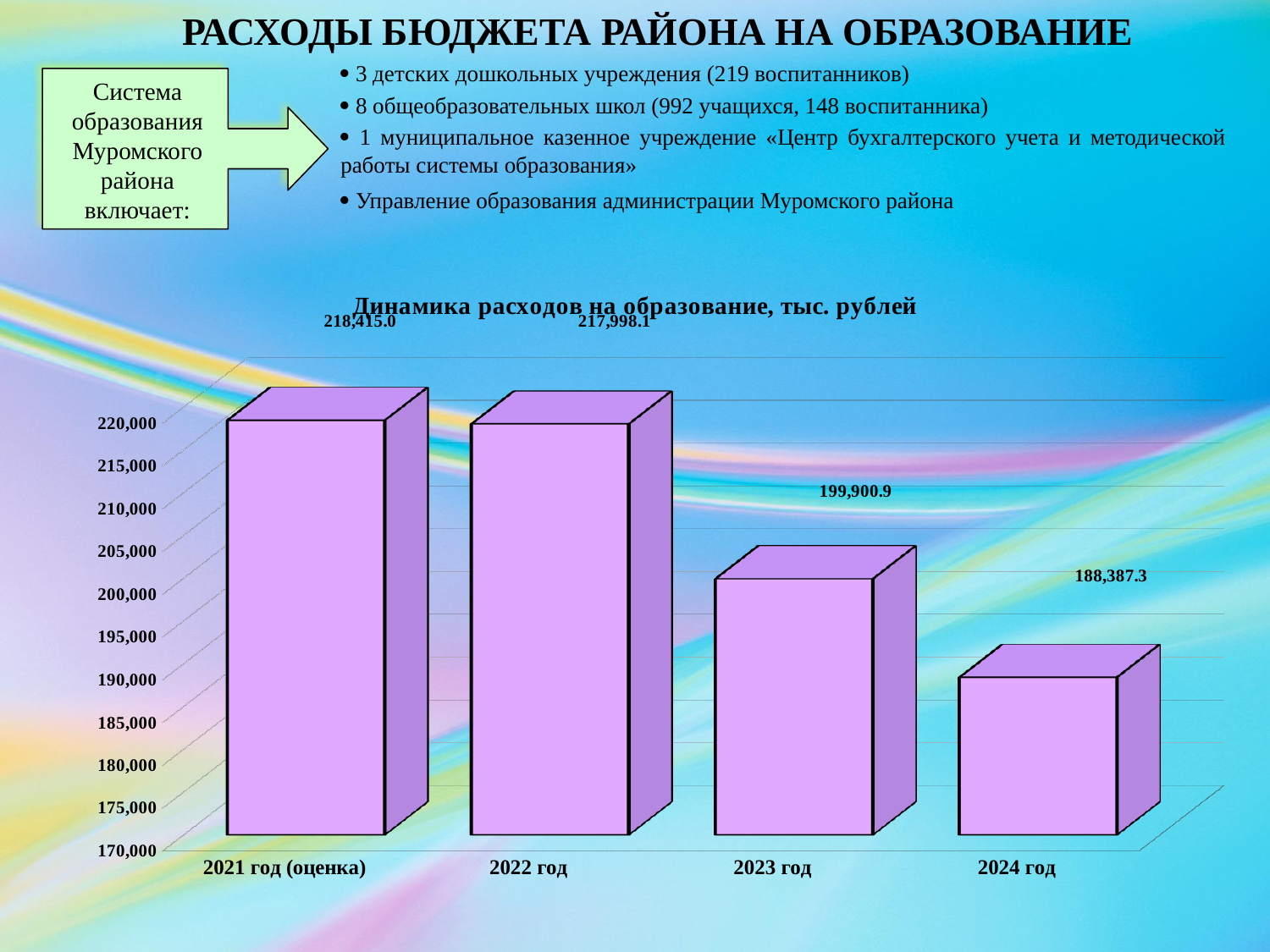
What is the value for 2024 год? 188,387.3 Which year has the highest expenditure on education? 2021 год (оценка) What is the value for 2021 год (оценка)? 218,415.0 What type of chart is shown on the slide? bar chart What is the value for 2022 год? 217,998.1 How many years (categories) are plotted in the chart? 4 What is the title of the chart? Динамика расходов на образование, тыс. рублей What is the value for 2023 год? 199,900.9 What is the difference between the values for 2023 год and 2024 год? 11,513.6 Which is larger, the value for 2022 год or the value for 2023 год? 2022 год Which year has the lowest expenditure on education? 2024 год Do the values rise or fall from 2021 to 2024? fall